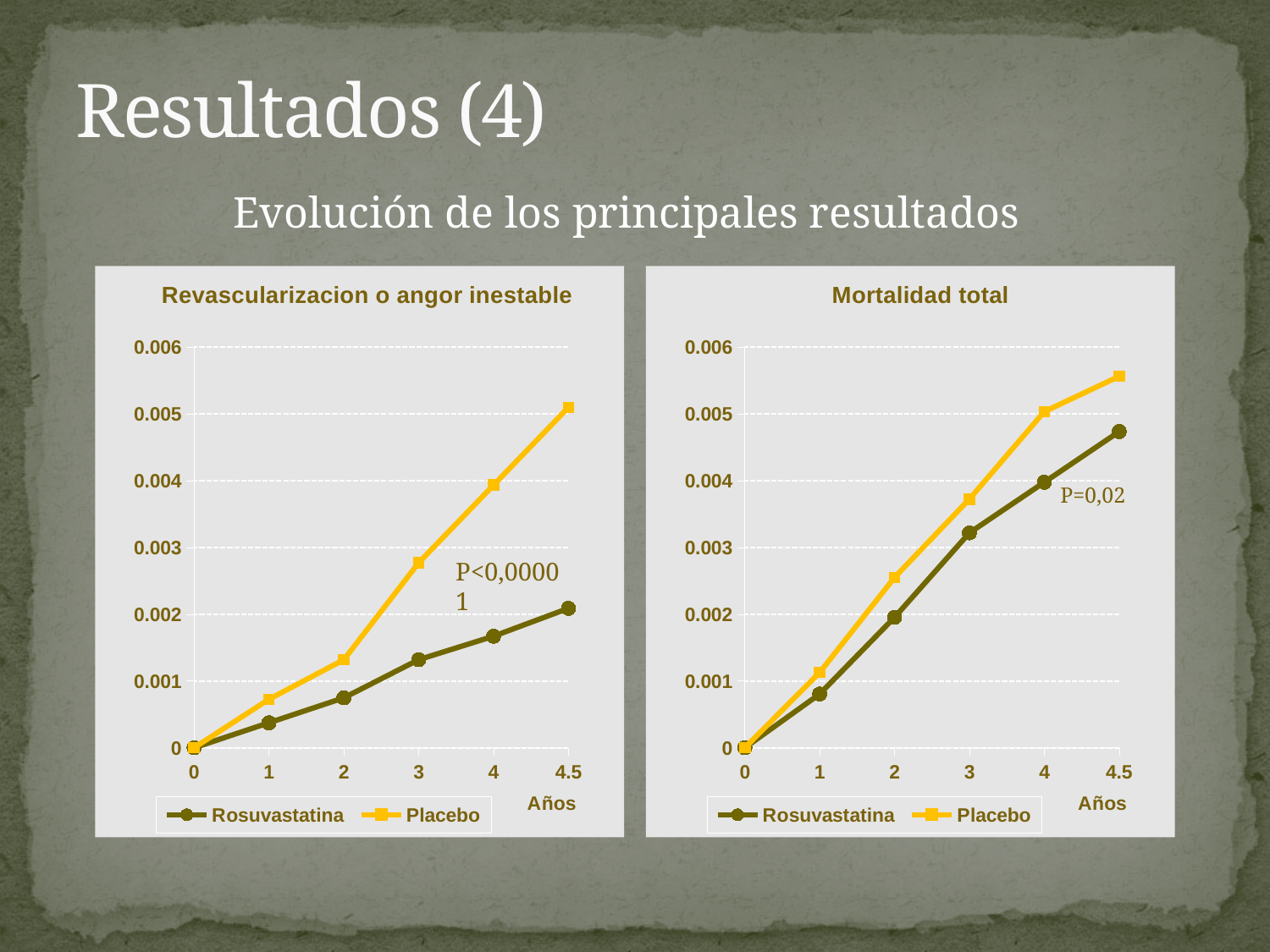
In the 'Revascularizacion o angor inestable' chart, is the value for Rosuvastatina at year 4 greater or less than 0.002? less In the 'Revascularizacion o angor inestable' chart, which series has the higher value at year 4.5, Rosuvastatina or Placebo? Placebo In the 'Mortalidad total' chart, is the value for Rosuvastatina at year 4.5 greater or less than 0.005? less In the 'Revascularizacion o angor inestable' chart, what is the value for Placebo at year 0? 0 In the 'Revascularizacion o angor inestable' chart, is the value for Placebo at year 3 greater or less than 0.003? less What is the x-axis label on the 'Revascularizacion o angor inestable' chart? Años How many series does the legend of the 'Mortalidad total' chart list? 2 In the 'Mortalidad total' chart, do the values for Placebo rise or fall as the years increase? rise What P value is annotated on the 'Mortalidad total' chart? P=0,02 How many time points are plotted along the x axis of the 'Revascularizacion o angor inestable' chart? 6 What kind of chart is the 'Revascularizacion o angor inestable' chart? line chart